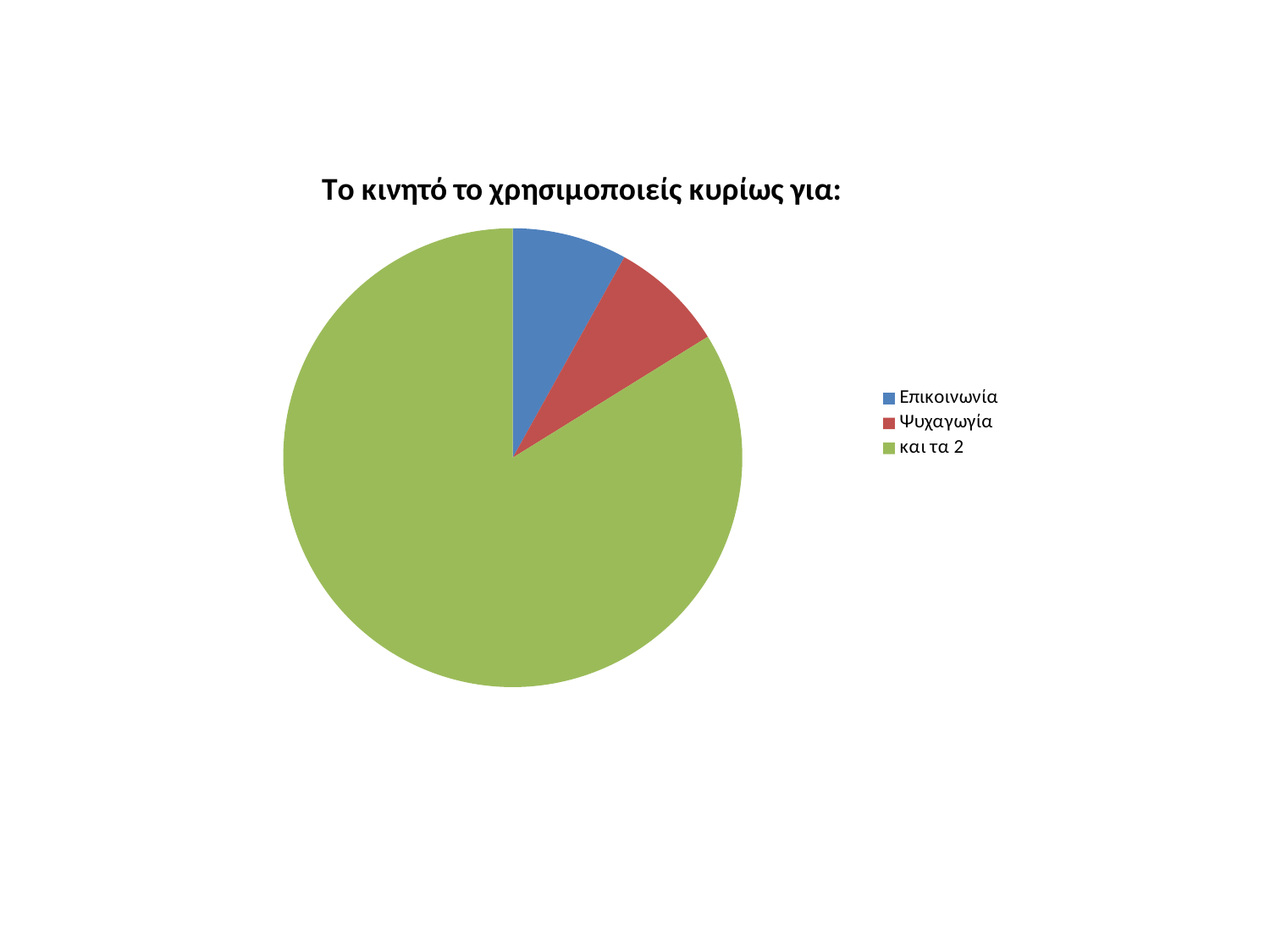
Which is larger, the slice for Ψυχαγωγία or the slice for και τα 2? και τα 2 What is the title of the chart? Το κινητό το χρησιμοποιείς κυρίως για: What colour is the slice for Ψυχαγωγία? red What kind of chart is shown on the slide? pie chart How many slices does the pie chart have? 3 Which is larger, the slice for και τα 2 or the slice for Επικοινωνία? και τα 2 Which category has the largest slice of the pie? και τα 2 How many entries does the legend list? 3